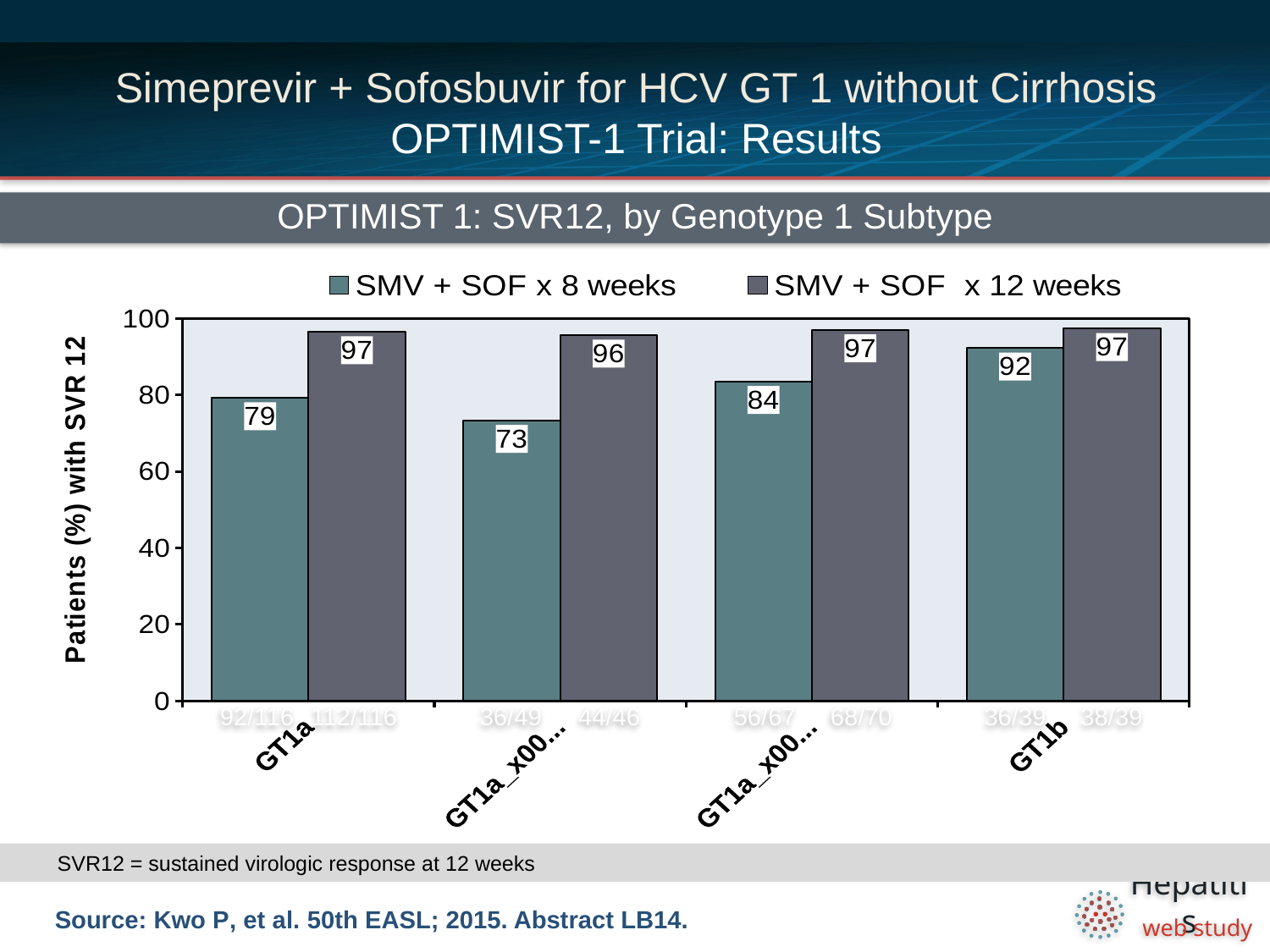
How many genotype subtype categories are shown on the x axis? 4 What is the SVR12 rate for GT1b with SMV + SOF x 8 weeks? 92 What is the SVR12 rate for GT1a with SMV + SOF x 12 weeks? 97 For GT1b, what is the difference between the 12-week and 8-week SVR12 rates? 5 What kind of chart is shown on the slide? Bar chart For GT1a, how many percentage points higher is the 12-week SVR12 rate than the 8-week rate? 18 What is the lowest SVR12 value shown for the SMV + SOF x 8 weeks series? 73 Which has the higher SVR12 rate with SMV + SOF x 8 weeks, GT1a or GT1b? GT1b What is the SVR12 rate for GT1a with SMV + SOF x 8 weeks? 79 What is the SVR12 rate for GT1b with SMV + SOF x 12 weeks? 97 What is the title of the chart? OPTIMIST 1: SVR12, by Genotype 1 Subtype How many series does the legend list? 2